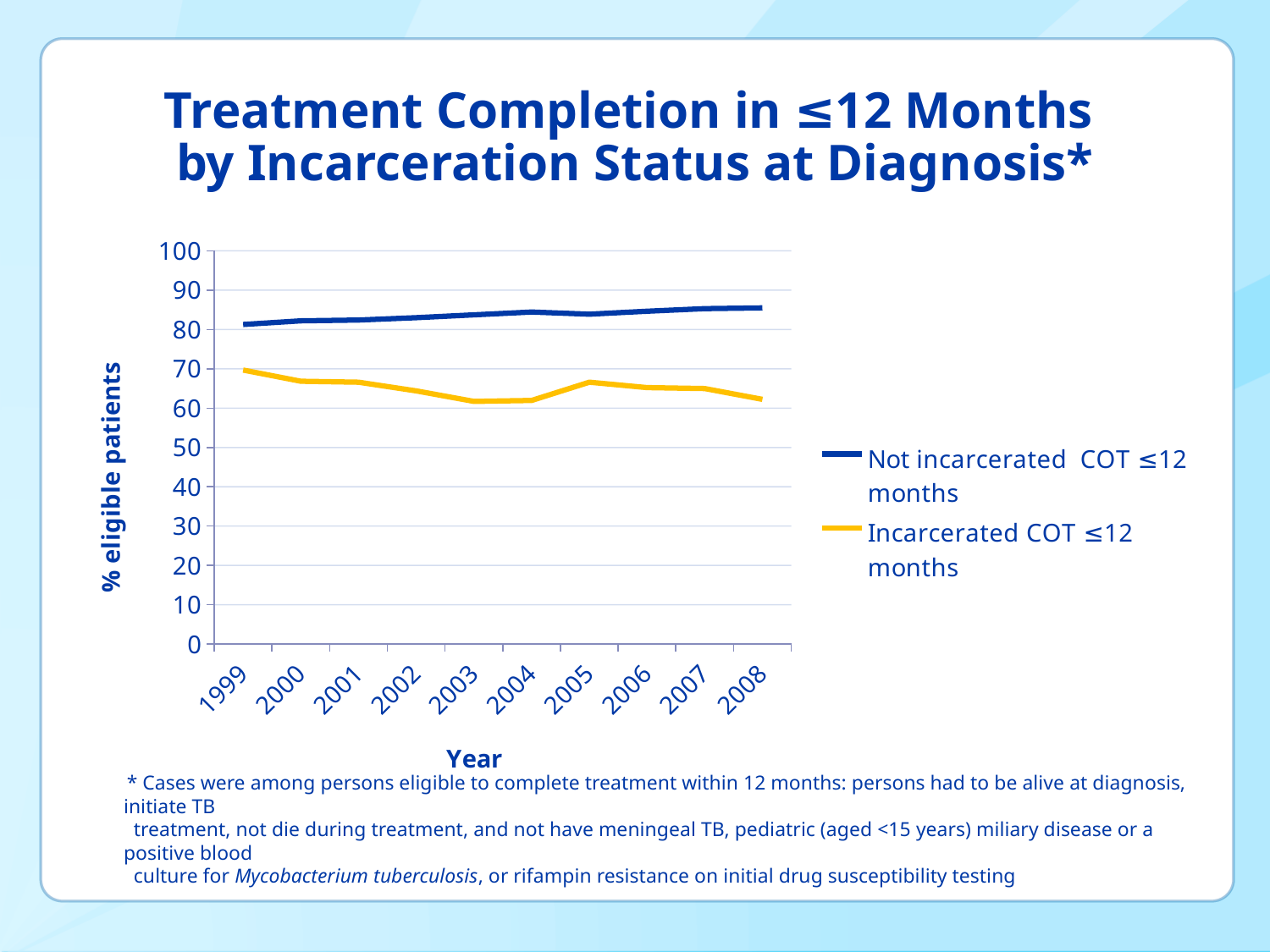
Which series has the lower value in 1999, Not incarcerated COT ≤12 months or Incarcerated COT ≤12 months? Incarcerated COT ≤12 months Is the value for Incarcerated COT ≤12 months in 2003 greater or less than 70? less In which year is the Incarcerated COT ≤12 months series at its highest? 1999 What kind of chart is shown on the slide? line chart Does the Incarcerated COT ≤12 months series rise or fall overall from 1999 to 2008? fall Is the value for Incarcerated COT ≤12 months in 2008 greater or less than 70? less Is the value for Not incarcerated COT ≤12 months in 2004 greater or less than 90? less How many years are plotted along the x axis? 10 What is the label on the y axis? % eligible patients Which series has the higher value in 2005, Not incarcerated COT ≤12 months or Incarcerated COT ≤12 months? Not incarcerated COT ≤12 months How many series does the legend list? 2